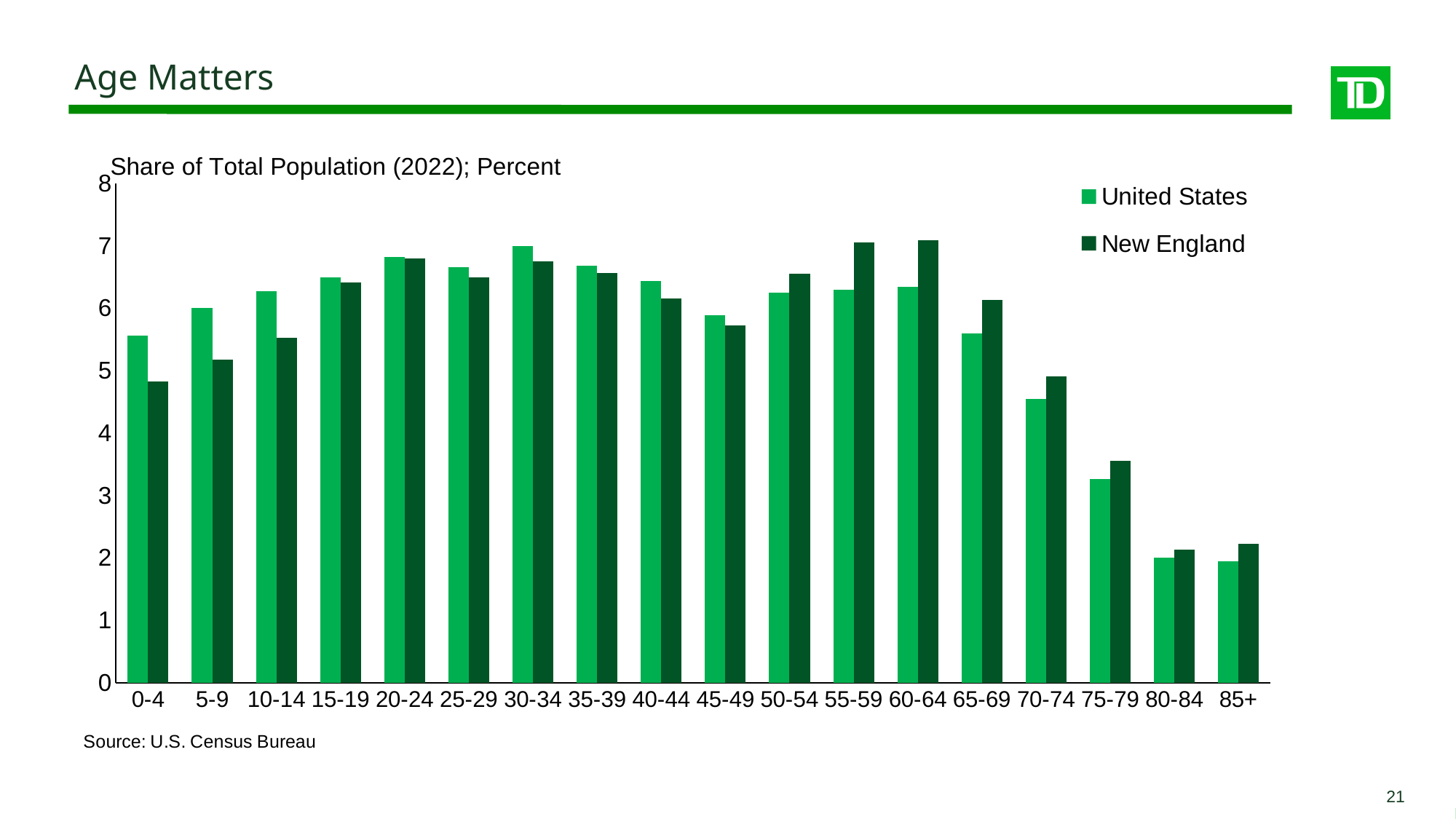
Which age group has the highest United States value? 30-34 For the 60-64 age group, which is larger: United States or New England? New England Do the United States values rise or fall from 65-69 to 85+? fall What is the title of the chart? Share of Total Population (2022); Percent Is the New England value for 75-79 greater or less than 3? greater Is the New England value for 0-4 greater or less than 5? less For the 0-4 age group, which is larger: United States or New England? United States Is the United States value for 70-74 greater or less than 4? greater What kind of chart is shown on the slide? bar chart How many series does the legend list? 2 How many age groups are shown on the x axis? 18 For the 70-74 age group, which is larger: United States or New England? New England